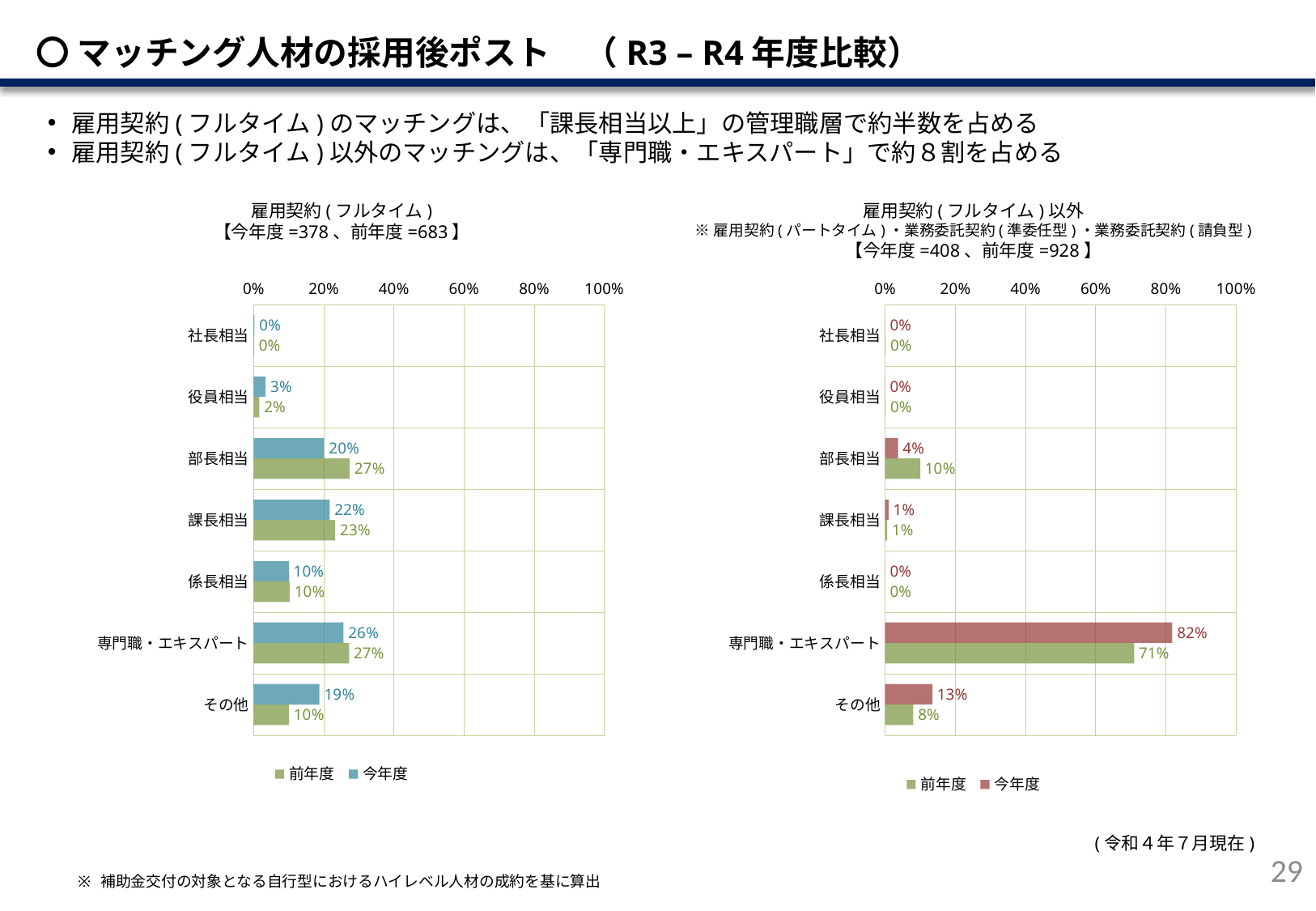
In the left chart (雇用契約(フルタイム)), is the 前年度 value for 部長相当 larger or smaller than the 今年度 value for 部長相当? larger How many series does the legend of the right chart (雇用契約(フルタイム)以外) list? 2 In the left chart (雇用契約(フルタイム)), what is the 今年度 value for 部長相当? 20% In the right chart (雇用契約(フルタイム)以外), what is the difference between the 今年度 and 前年度 values for 専門職・エキスパート? 11% In the left chart (雇用契約(フルタイム)), which category has the highest 今年度 value? 専門職・エキスパート In the right chart (雇用契約(フルタイム)以外), what is the 前年度 value for 部長相当? 10% In the right chart (雇用契約(フルタイム)以外), what is the 今年度 value for 専門職・エキスパート? 82% In the right chart (雇用契約(フルタイム)以外), which category has the highest 前年度 value? 専門職・エキスパート What type of chart is the right chart (雇用契約(フルタイム)以外)? bar chart How many categories are shown on the y axis of the left chart (雇用契約(フルタイム))? 7 In the left chart (雇用契約(フルタイム)), what is the difference between the 今年度 and 前年度 values for その他? 9% In the left chart (雇用契約(フルタイム)), what is the 前年度 value for その他? 10%